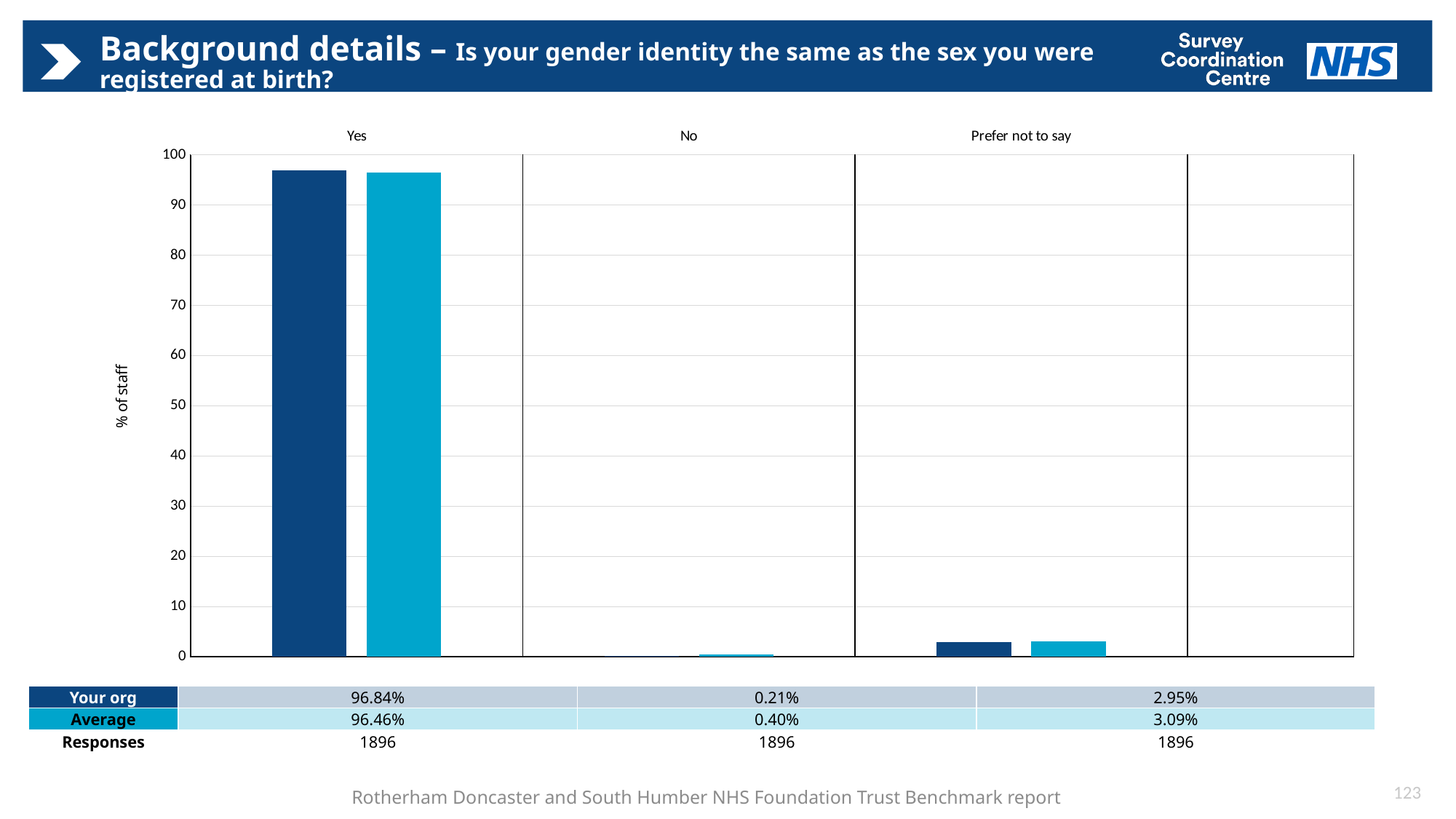
What is the difference between Your org and Average in the Yes category? 0.38% What is the Average value for the No category? 0.40% What is the value for Your org in the Yes category? 96.84% In the Prefer not to say category, which is larger: Your org or Average? Average Which category has the lowest value for Your org? No Which category has the highest value for Your org? Yes How many series does the chart show? 2 What is the value for Your org in the Prefer not to say category? 2.95% Is the Your org value for Yes greater or less than 90? greater What kind of chart is shown on the slide? bar chart What is the Average value for the Prefer not to say category? 3.09% How many categories are shown on the chart? 3